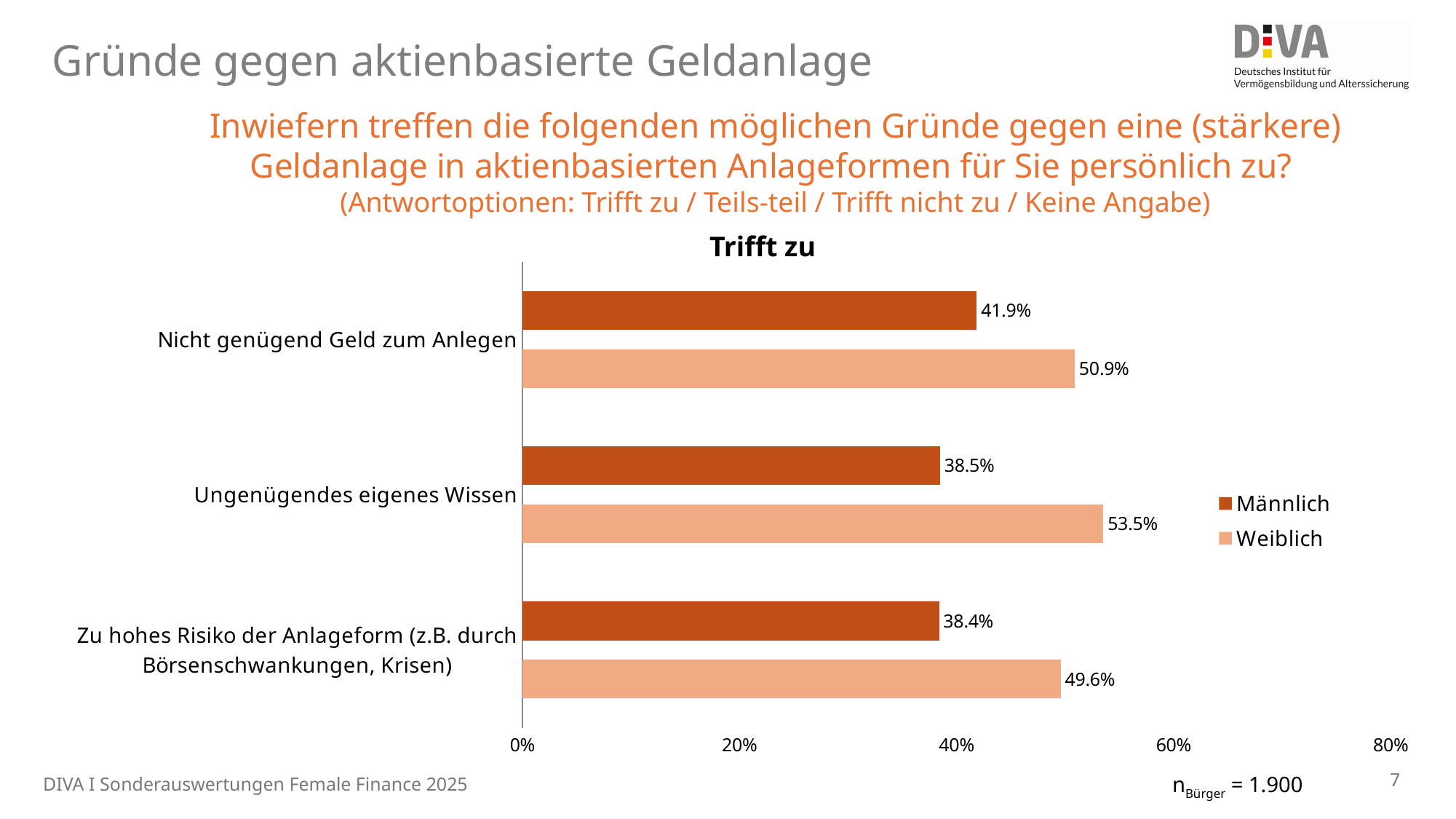
What is the difference between the Weiblich and Männlich values for 'Ungenügendes eigenes Wissen'? 15.0% Which is larger for 'Zu hohes Risiko der Anlageform', the Männlich value or the Weiblich value? Weiblich Which category has the highest value for Weiblich? Ungenügendes eigenes Wissen What is the value for Männlich for 'Nicht genügend Geld zum Anlegen'? 41.9% Is the Weiblich value for 'Nicht genügend Geld zum Anlegen' greater or less than 40%? greater How many categories are shown on the chart? 3 What kind of chart is shown on the slide? Bar chart What is the value for Weiblich for 'Zu hohes Risiko der Anlageform (z.B. durch Börsenschwankungen, Krisen)'? 49.6% What is the value for Weiblich for 'Ungenügendes eigenes Wissen'? 53.5% What is the difference between the Weiblich and Männlich values for 'Nicht genügend Geld zum Anlegen'? 9.0% How many series does the legend list? 2 Which category has the highest value for Männlich? Nicht genügend Geld zum Anlegen